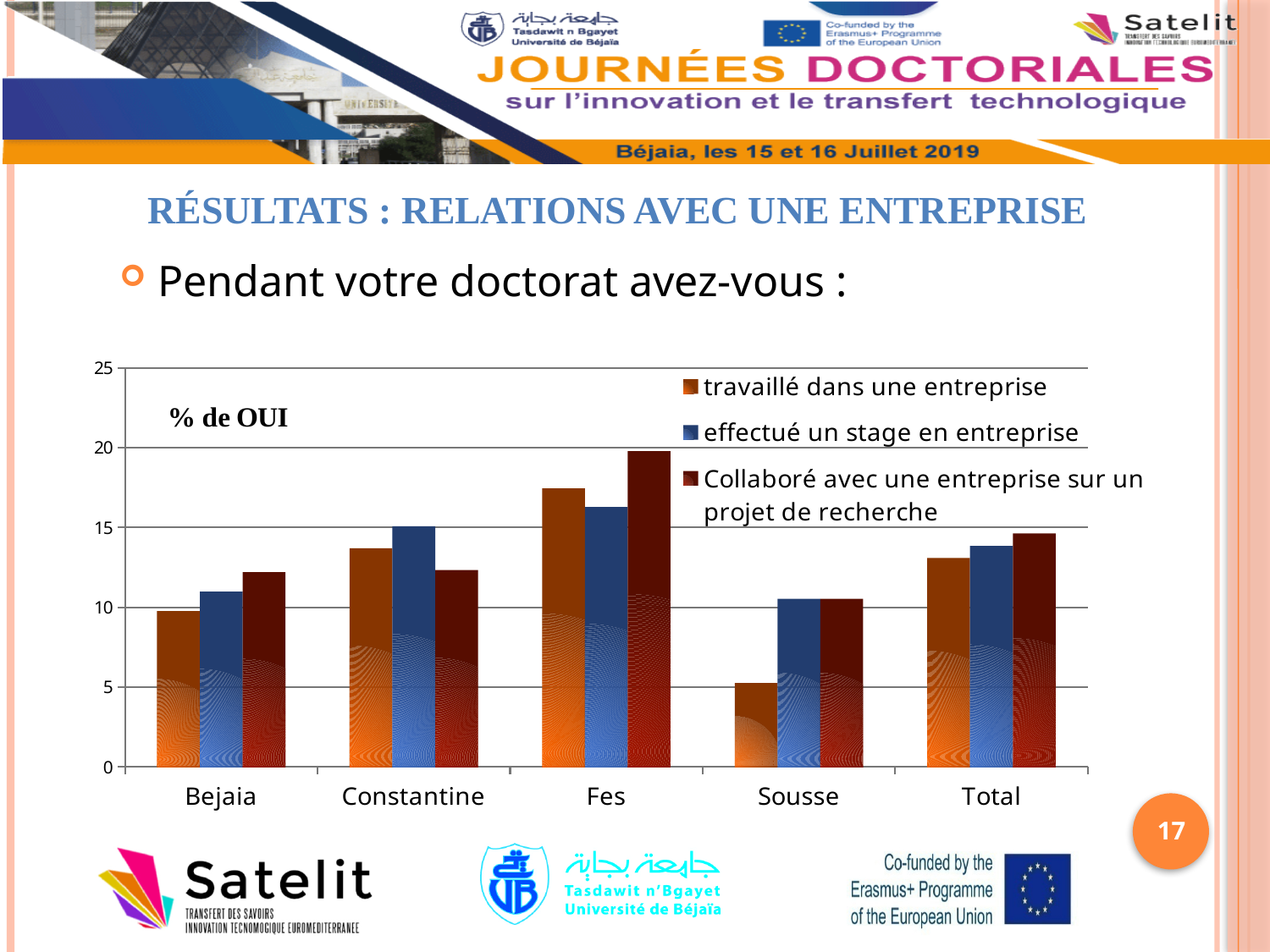
How many series does the chart's legend list? 3 What kind of chart is shown on the slide? bar chart Which category has the highest value for 'Collaboré avec une entreprise sur un projet de recherche'? Fes Is the value for 'Collaboré avec une entreprise sur un projet de recherche' in Fes greater or less than 15? greater Is the value for 'Collaboré avec une entreprise sur un projet de recherche' in Bejaia greater or less than 10? greater How many categories are shown on the x axis of the chart? 5 Which is larger: the value for 'effectué un stage en entreprise' in Bejaia or in Constantine? Constantine What text label is printed inside the plot area near the top left of the chart? % de OUI Which category has the highest value for 'travaillé dans une entreprise'? Fes Is the value for 'travaillé dans une entreprise' in Sousse greater or less than 10? less Which category has the lowest value for 'travaillé dans une entreprise'? Sousse Which is larger: the value for 'travaillé dans une entreprise' in Fes or in Sousse? Fes